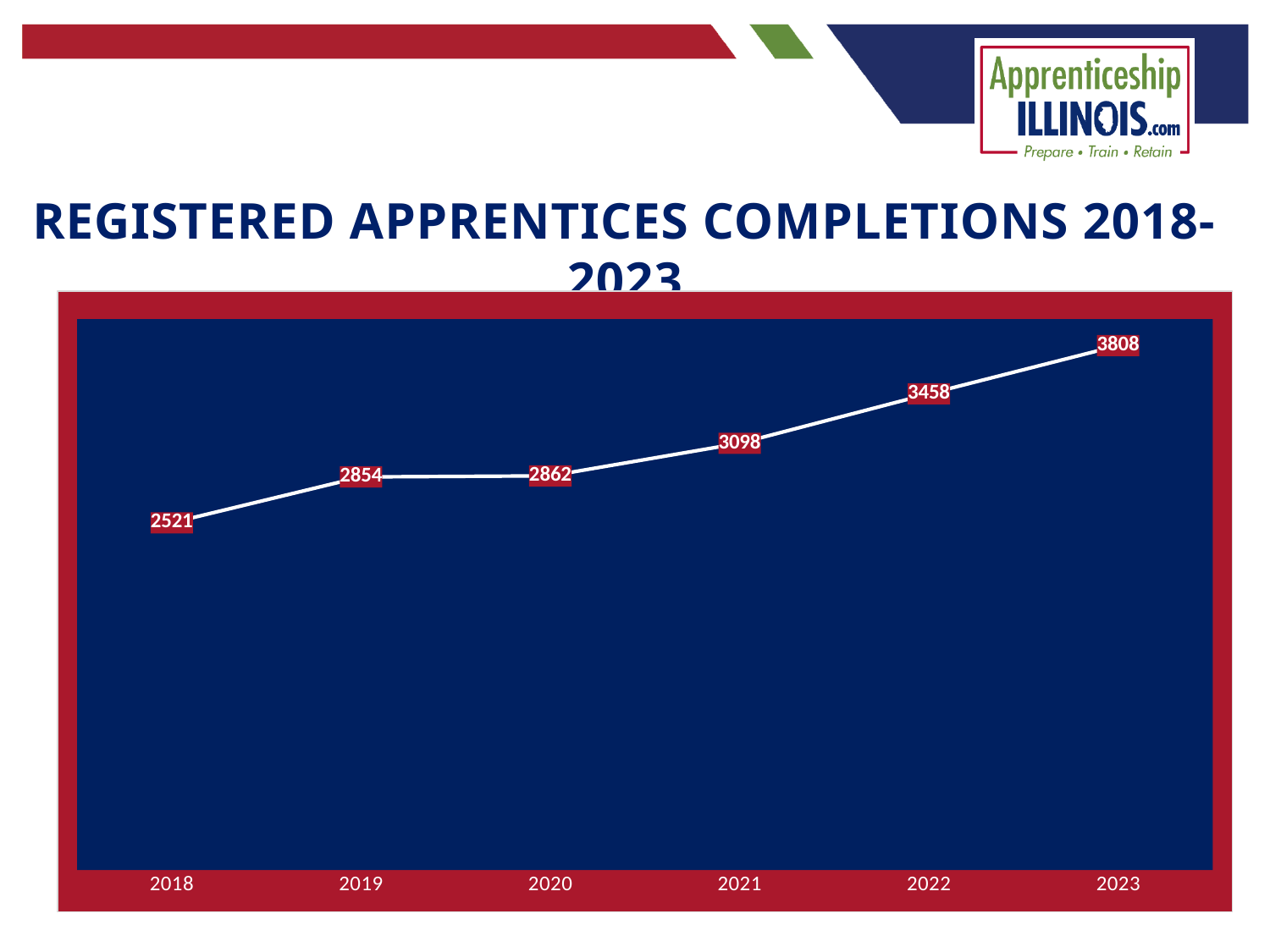
What is the difference between the values for 2020 and 2019? 8 Which is larger, the value for 2022 or the value for 2021? 2022 What is the title of the chart? REGISTERED APPRENTICES COMPLETIONS 2018-2023 How many years are plotted on the chart? 6 What is the value for 2023? 3808 What is the value for 2018? 2521 Do the values rise or fall from 2018 to 2023? rise What kind of chart is shown? line chart What is the value for 2021? 3098 Which year has the lowest value? 2018 Which year has the highest value? 2023 What is the difference between the values for 2023 and 2018? 1287